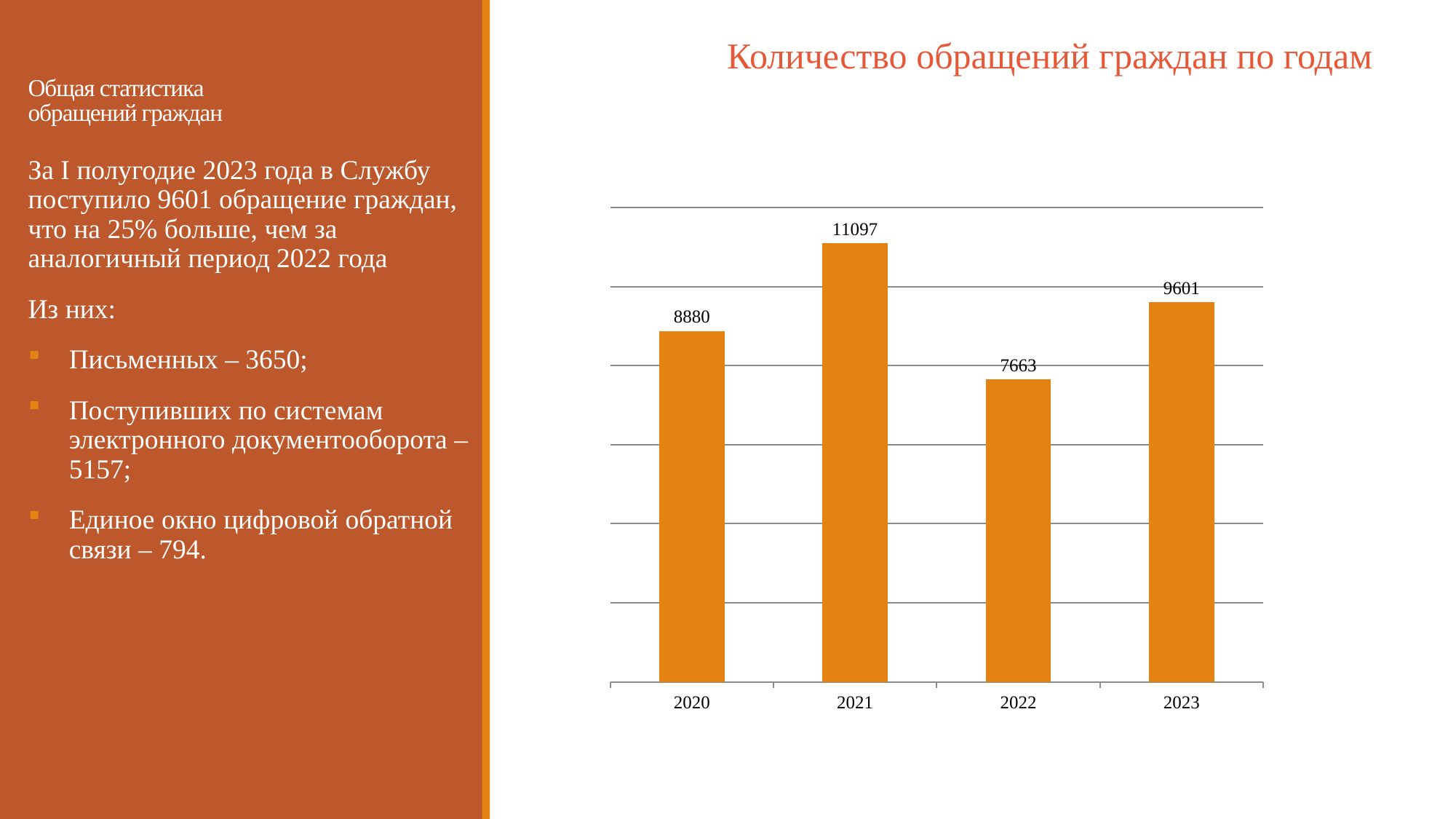
What is the difference between the values for 2021 and 2022? 3434 Which year has the lowest value? 2022 What is the value for 2022? 7663 Which year has the highest value? 2021 What is the difference between the values for 2023 and 2020? 721 What is the value for 2020? 8880 What is the value for 2021? 11097 What is the value for 2023? 9601 What is the title of the chart? Количество обращений граждан по годам Which is larger, the value for 2020 or the value for 2023? 2023 What kind of chart is shown on the slide? Bar chart How many years are shown on the x axis? 4